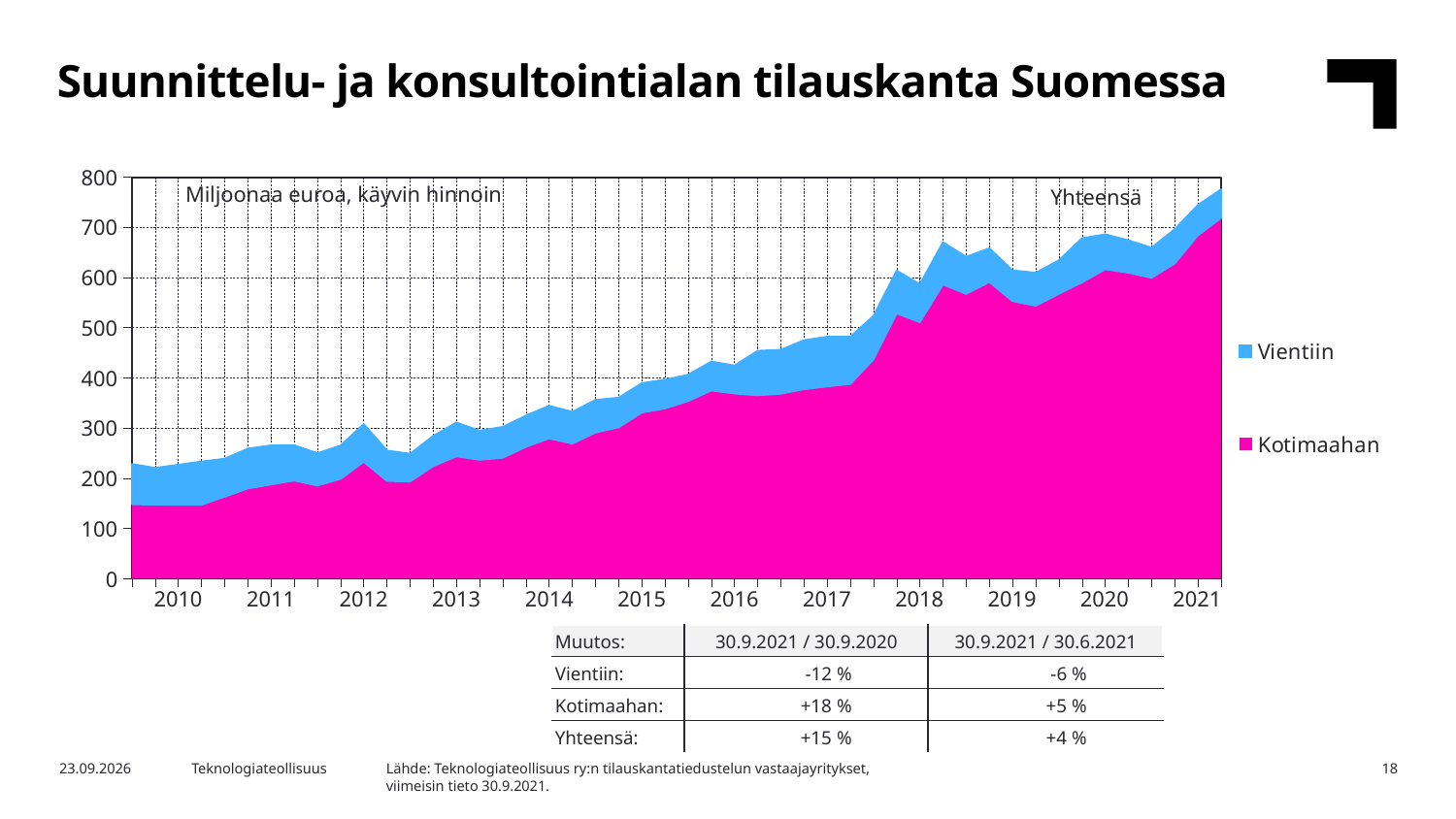
Which series is larger in 2021, Vientiin or Kotimaahan? Kotimaahan How many years are labelled on the x axis of the chart? 12 In which year does the total (Yhteensä) reach its highest level? 2021 What are the two series named in the chart legend? Vientiin and Kotimaahan Is the total (Yhteensä) at the end of 2021 greater or less than 700? greater Is the value for Kotimaahan at the end of 2021 greater or less than 600? greater How many series does the chart legend list? 2 Does the total order backlog (Yhteensä) generally rise or fall from 2010 to 2021? Rise Is the value for Kotimaahan at the start of 2010 greater or less than 200? less What kind of chart is shown on the slide? Stacked area chart What unit label is shown inside the chart area? Miljoonaa euroa, käyvin hinnoin